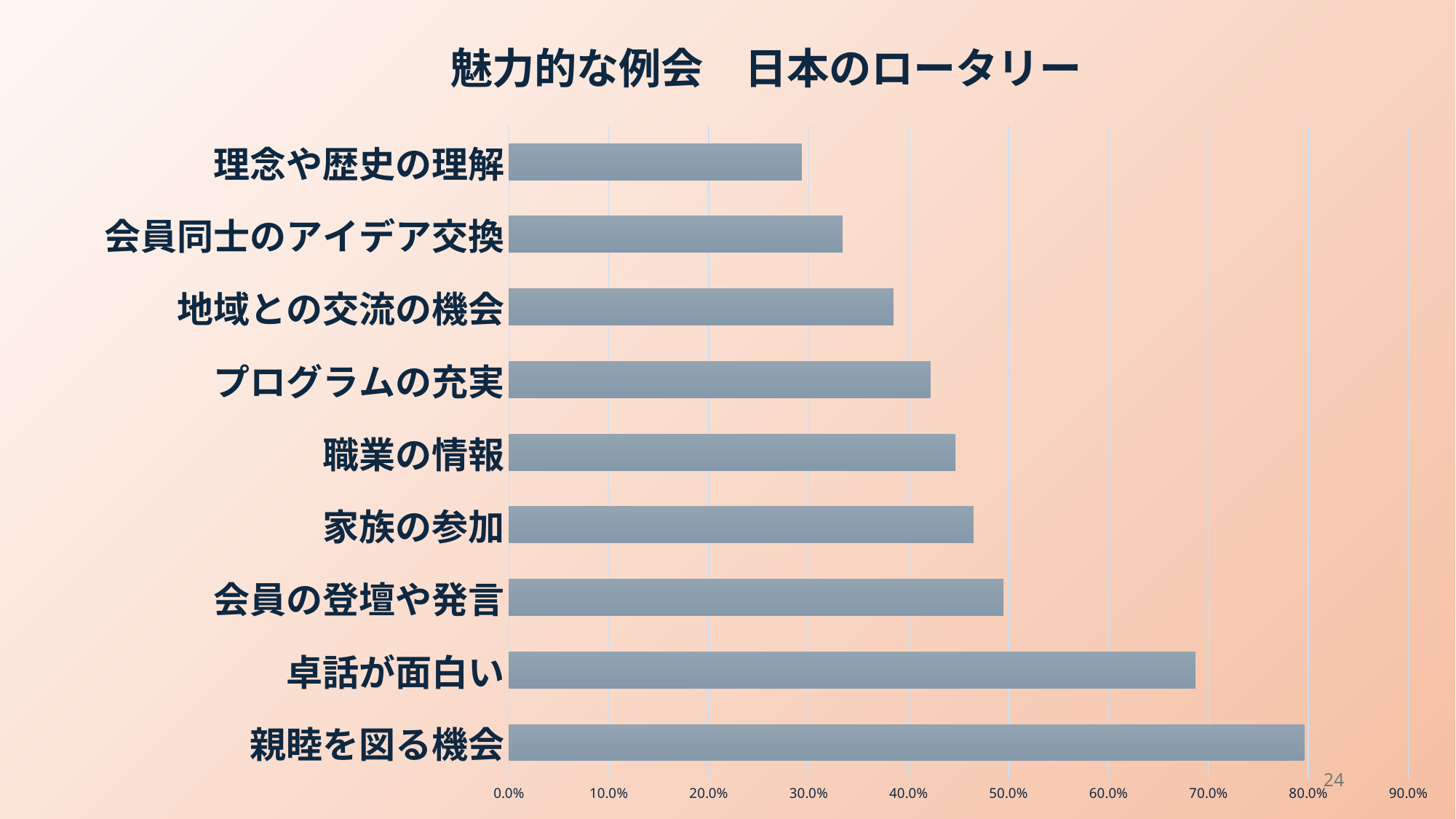
How many categories are plotted in the chart? 9 What kind of chart is shown on the slide? bar chart Which is larger, the value for 卓話が面白い or the value for 会員の登壇や発言? 卓話が面白い Is the value for 親睦を図る機会 greater or less than 70.0%? greater What is the title of the chart? 魅力的な例会 日本のロータリー Which is larger, the value for 会員同士のアイデア交換 or the value for プログラムの充実? プログラムの充実 Which category has the highest value? 親睦を図る機会 Is the value for 地域との交流の機会 greater or less than 40.0%? less Which category has the lowest value? 理念や歴史の理解 Is the value for 卓話が面白い greater or less than 60.0%? greater